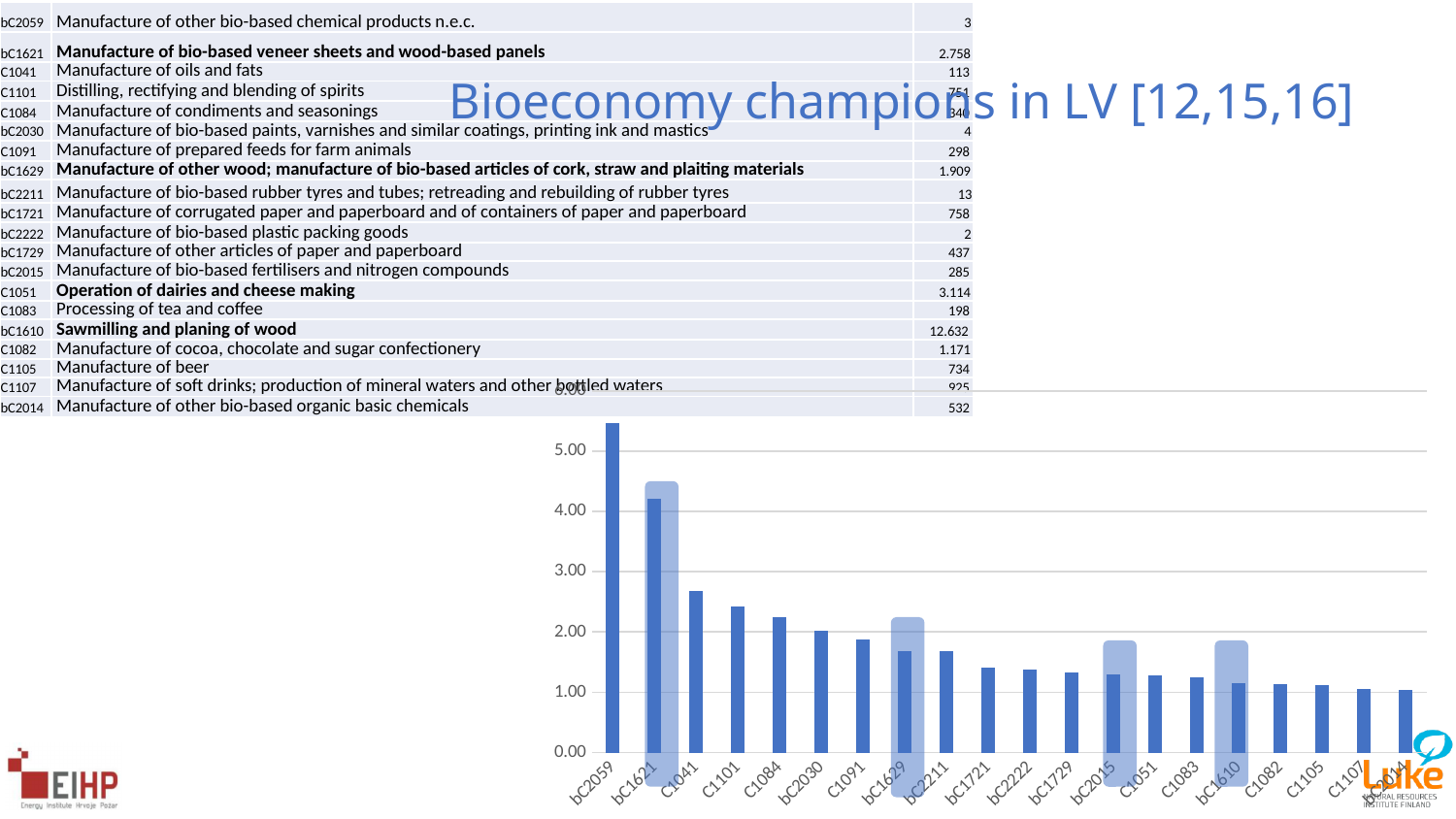
What is the title shown on the slide above the chart? Bioeconomy champions in LV [12,15,16] What kind of chart is shown on the slide? bar chart Is the value for C1041 greater or less than 3.00? less Which category has the highest bar in the chart? bC2059 Which category has the lowest bar in the chart? bC2014 Which has the larger value, bC1621 or C1041? bC1621 How many categories are plotted along the x axis of the bar chart? 20 Is the value for bC2059 greater or less than 5.00? greater Do the bar values generally rise or fall from left to right along the x axis? fall Is the value for C1084 greater or less than 2.00? greater